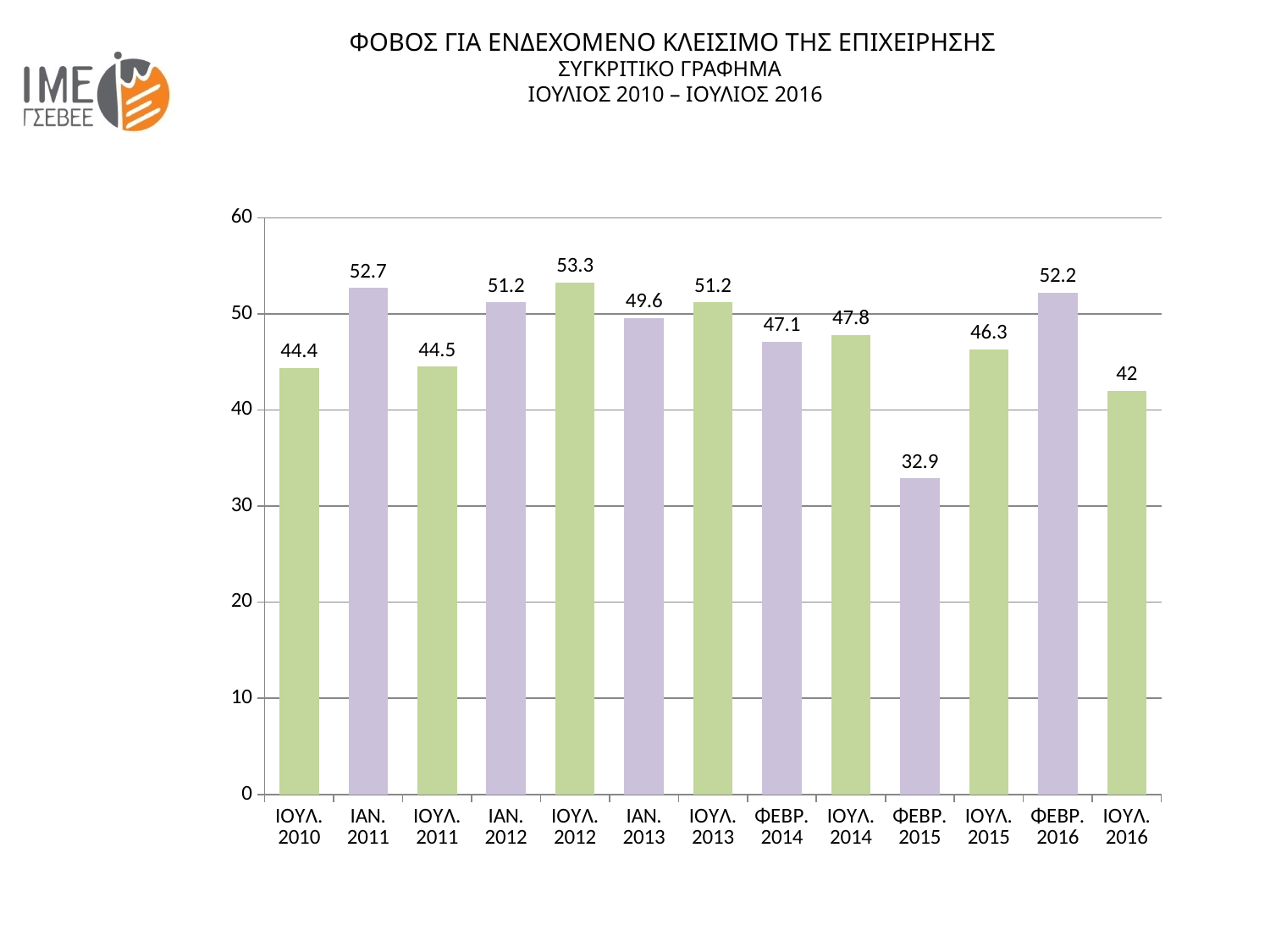
What is the value for ΦΕΒΡ. 2015? 32.9 Does the value rise or fall from ΦΕΒΡ. 2016 to ΙΟΥΛ. 2016? fall What is the value for ΙΟΥΛ. 2016? 42 How many categories are shown on the x axis? 13 What kind of chart is shown on the slide? bar chart Which is larger, the value for ΦΕΒΡ. 2016 or the value for ΙΟΥΛ. 2015? ΦΕΒΡ. 2016 What is the value for ΙΟΥΛ. 2010? 44.4 What is the main title of the chart? ΦΟΒΟΣ ΓΙΑ ΕΝΔΕΧΟΜΕΝΟ ΚΛΕΙΣΙΜΟ ΤΗΣ ΕΠΙΧΕΙΡΗΣΗΣ Which category has the lowest value? ΦΕΒΡ. 2015 Is the value for ΙΟΥΛ. 2014 greater or less than 50? less Which category has the highest value? ΙΟΥΛ. 2012 What is the difference between the values for ΙΑΝ. 2011 and ΙΟΥΛ. 2011? 8.2